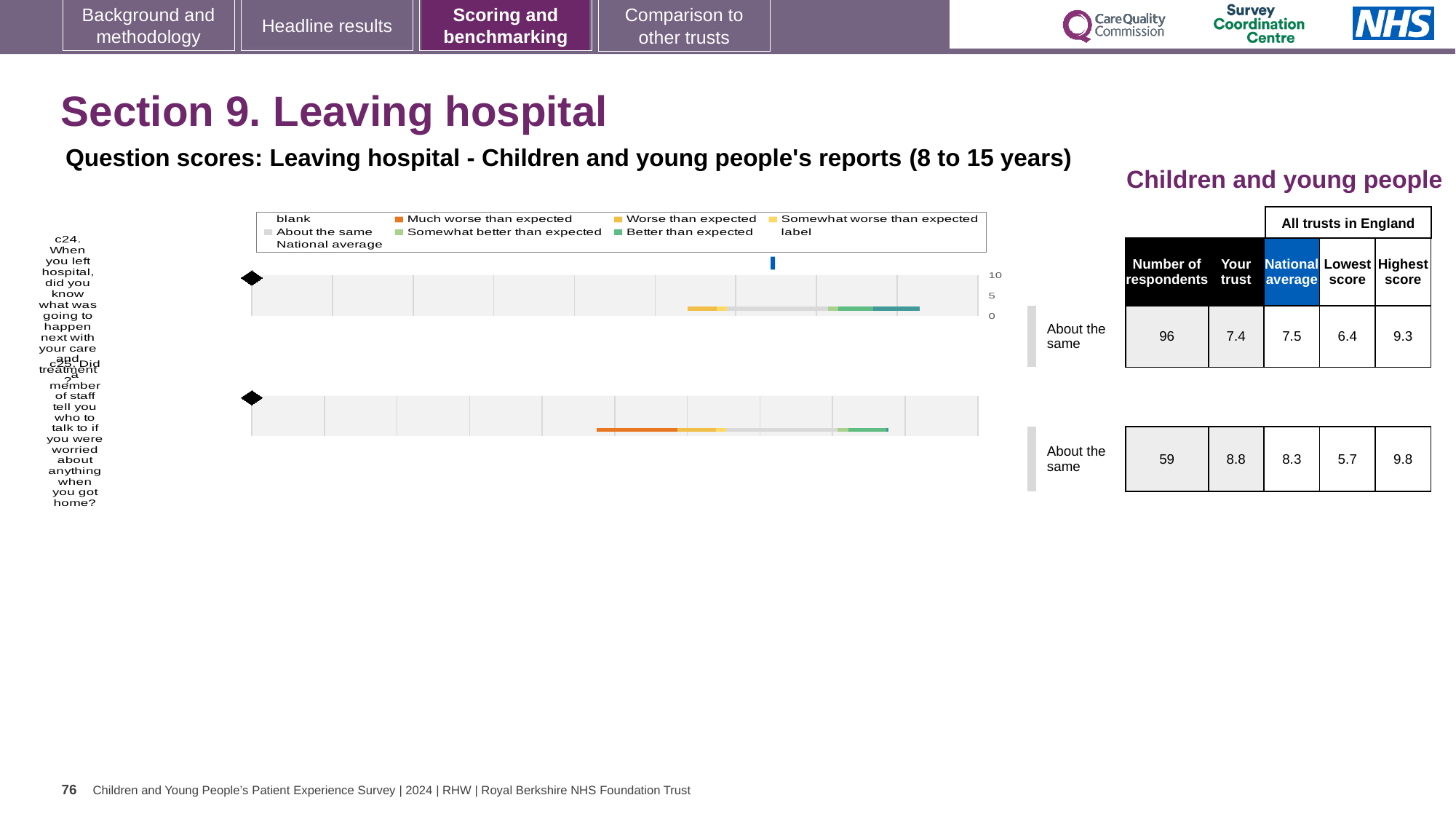
What is the highest score among all trusts in England for question c24? 9.3 Which question has the higher 'Your trust' score, c24 or c25? c25 How many questions are plotted in the chart? 2 What is the national average score for question c25 (Did a member of staff tell you who to talk to if you were worried about anything when you got home?)? 8.3 What is the 'Your trust' score for question c24 (When you left hospital, did you know what was going to happen next with your care and treatment?)? 7.4 What is the difference between the national average and the 'Your trust' score for question c24? 0.1 For question c25, which is larger: the 'Your trust' score or the national average? Your trust What is the difference between the highest score and the lowest score for question c25? 4.1 How many entries does the chart legend list? 9 What benchmark category is shown for question c25? About the same What kind of chart is shown on the slide? Bar chart How many respondents answered question c24? 96